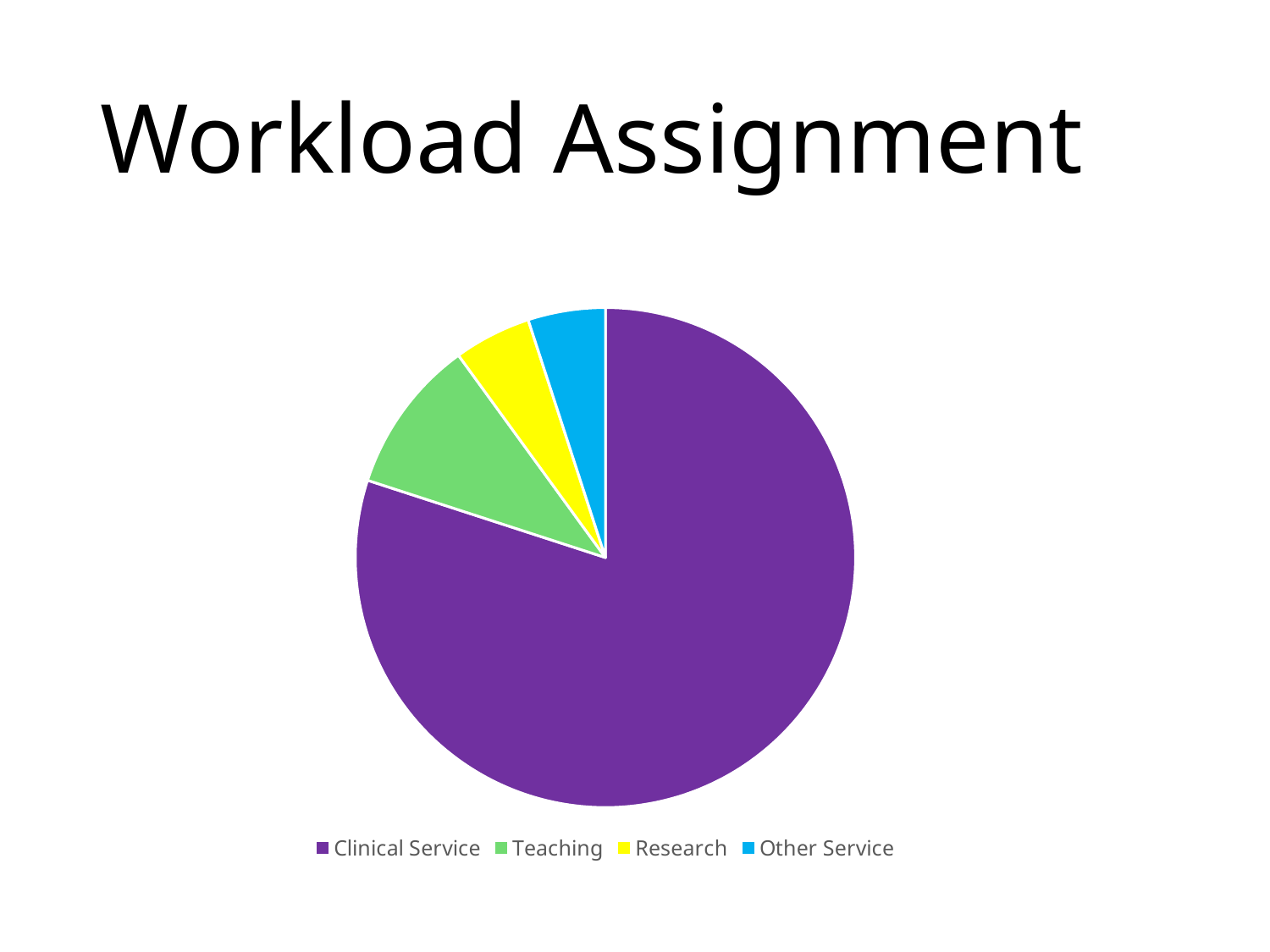
What colour is the Research slice in the pie chart? yellow Which is larger, the slice for Clinical Service or the slice for Teaching? Clinical Service What kind of chart is shown on the slide? pie chart Which is larger, the slice for Teaching or the slice for Research? Teaching Which category has the largest slice of the pie chart? Clinical Service How many slices does the pie chart have? 4 Which category has the second-largest slice of the pie chart? Teaching Which is larger, the slice for Clinical Service or the slice for Other Service? Clinical Service What is the title of the slide containing the pie chart? Workload Assignment